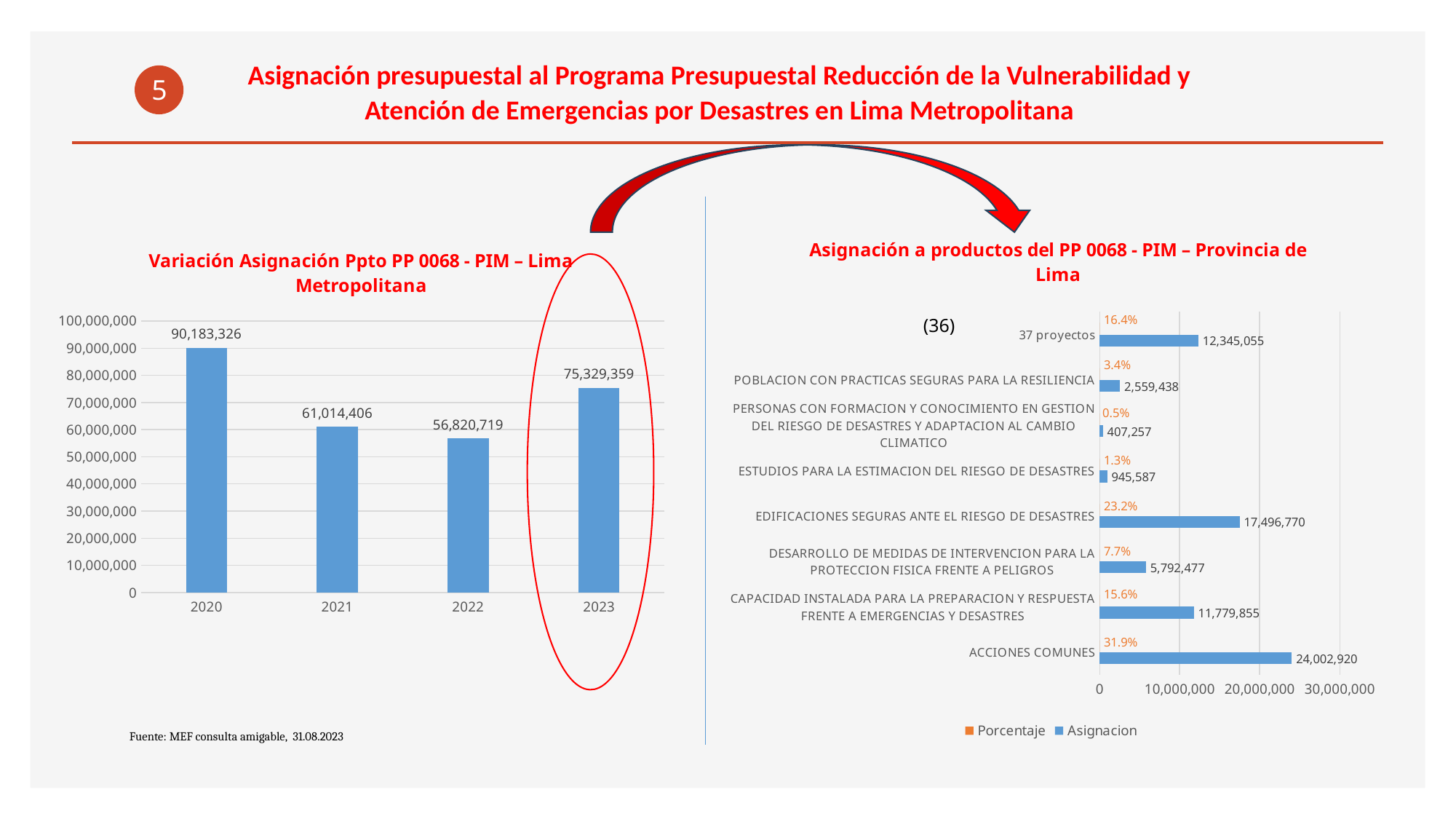
In the chart 'Variación Asignación Ppto PP 0068 - PIM – Lima Metropolitana', do the values rise or fall from 2020 to 2022? fall In the chart 'Variación Asignación Ppto PP 0068 - PIM – Lima Metropolitana', what is the difference between the 2020 and 2023 values? 14,853,967 In the chart 'Variación Asignación Ppto PP 0068 - PIM – Lima Metropolitana', how many years are shown on the x axis? 4 In the chart 'Variación Asignación Ppto PP 0068 - PIM – Lima Metropolitana', what is the value for 2020? 90,183,326 In the chart 'Asignación a productos del PP 0068 - PIM – Provincia de Lima', what percentage is shown for EDIFICACIONES SEGURAS ANTE EL RIESGO DE DESASTRES? 23.2% In the chart 'Asignación a productos del PP 0068 - PIM – Provincia de Lima', which category has the smallest Asignacion value? PERSONAS CON FORMACION Y CONOCIMIENTO EN GESTION DEL RIESGO DE DESASTRES Y ADAPTACION AL CAMBIO CLIMATICO In the chart 'Asignación a productos del PP 0068 - PIM – Provincia de Lima', how many series does the legend list? 2 In the chart 'Variación Asignación Ppto PP 0068 - PIM – Lima Metropolitana', which year has the lowest value? 2022 In the chart 'Asignación a productos del PP 0068 - PIM – Provincia de Lima', what is the Asignacion value for ACCIONES COMUNES? 24,002,920 In the chart 'Asignación a productos del PP 0068 - PIM – Provincia de Lima', which is larger: the Asignacion for 37 proyectos or for CAPACIDAD INSTALADA PARA LA PREPARACION Y RESPUESTA FRENTE A EMERGENCIAS Y DESASTRES? 37 proyectos In the chart 'Asignación a productos del PP 0068 - PIM – Provincia de Lima', what is the difference between the Asignacion values for ACCIONES COMUNES and EDIFICACIONES SEGURAS ANTE EL RIESGO DE DESASTRES? 6,506,150 What kind of chart is 'Variación Asignación Ppto PP 0068 - PIM – Lima Metropolitana'? bar chart